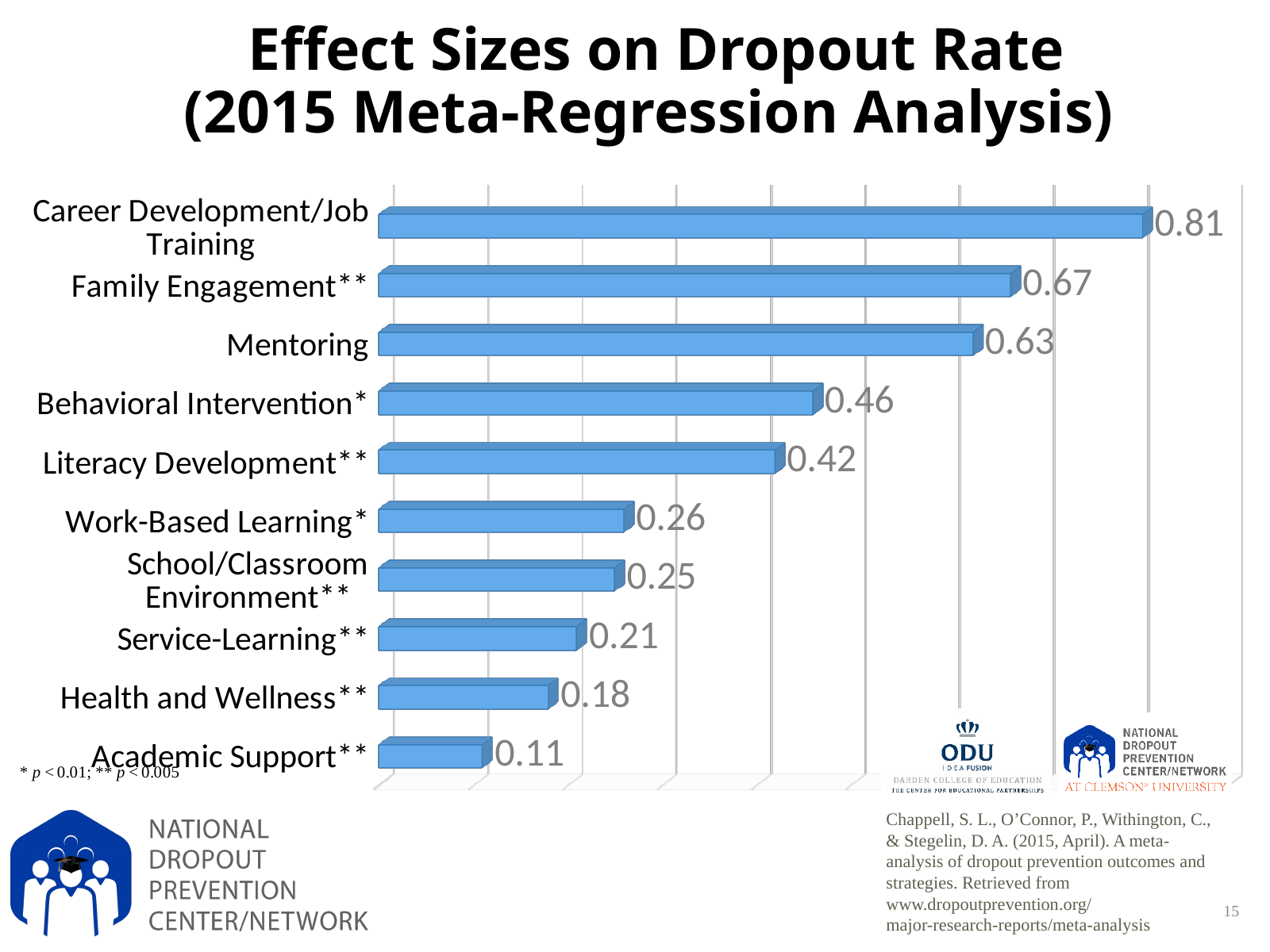
Which has a larger effect size, Service-Learning** or Health and Wellness**? Service-Learning** What is the difference between the effect sizes for Career Development/Job Training and Family Engagement**? 0.14 Which category has the highest effect size? Career Development/Job Training What is the effect size for Health and Wellness**? 0.18 How many categories are shown in the chart? 10 What is the difference between the effect sizes for Behavioral Intervention* and Work-Based Learning*? 0.20 What is the title of the chart on the slide? Effect Sizes on Dropout Rate (2015 Meta-Regression Analysis) What is the effect size for Mentoring? 0.63 What is the effect size for Literacy Development**? 0.42 What kind of chart is shown on the slide? Bar chart Which has a larger effect size, Mentoring or Behavioral Intervention*? Mentoring Which category has the lowest effect size? Academic Support**